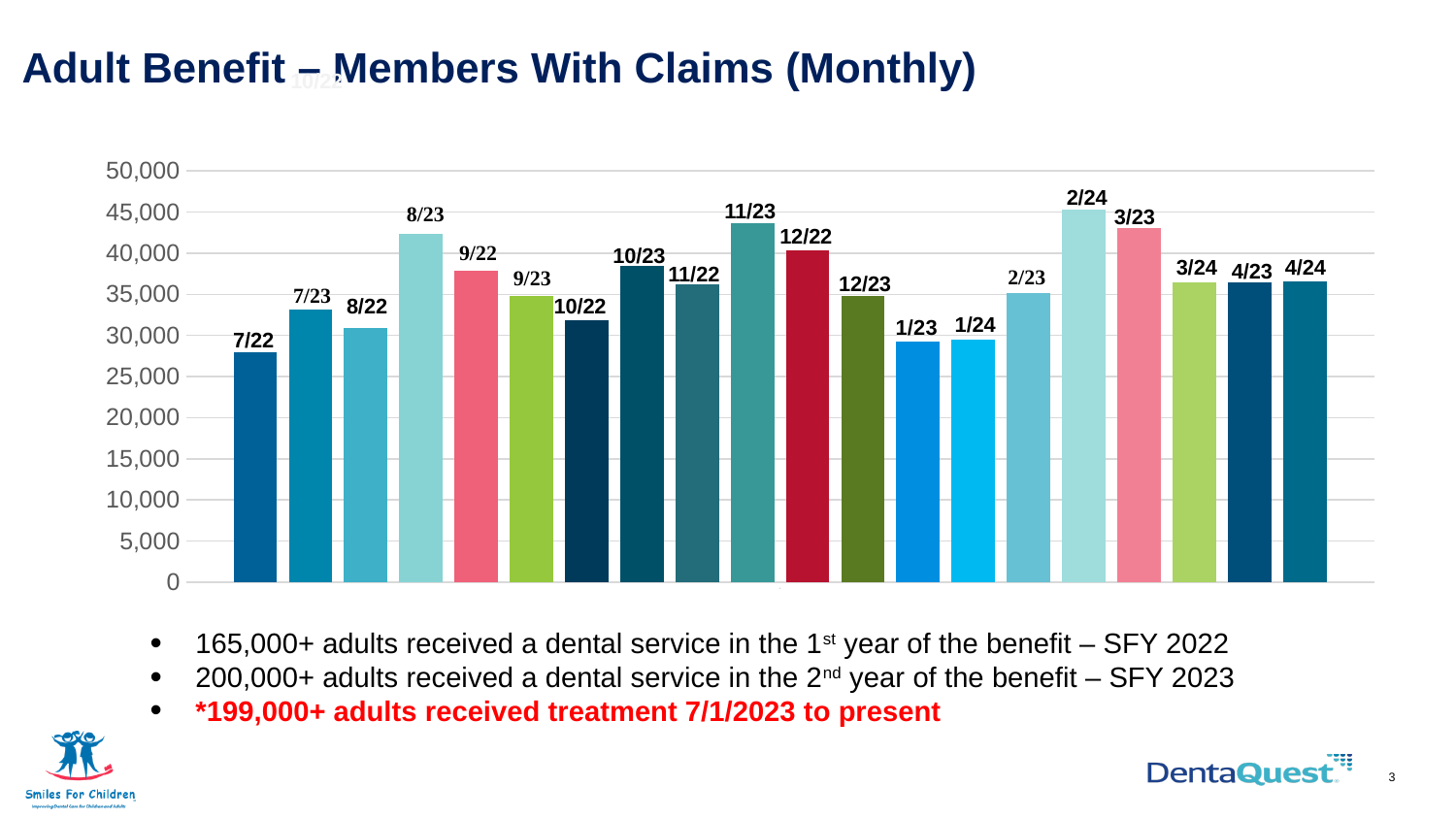
Which month has the highest bar in the chart? 2/24 Is the value for 8/23 greater or less than 40,000? greater How many bars (months) are plotted in the chart? 20 Is the value for 1/23 greater or less than 30,000? less Which is larger, the value for 12/22 or the value for 12/23? 12/22 What is the title of the chart? Adult Benefit – Members With Claims (Monthly) What kind of chart is shown on the slide? bar chart Which month has the lowest bar in the chart? 7/22 Is the value for 10/22 greater or less than 35,000? less Which is larger, the value for 8/22 or the value for 8/23? 8/23